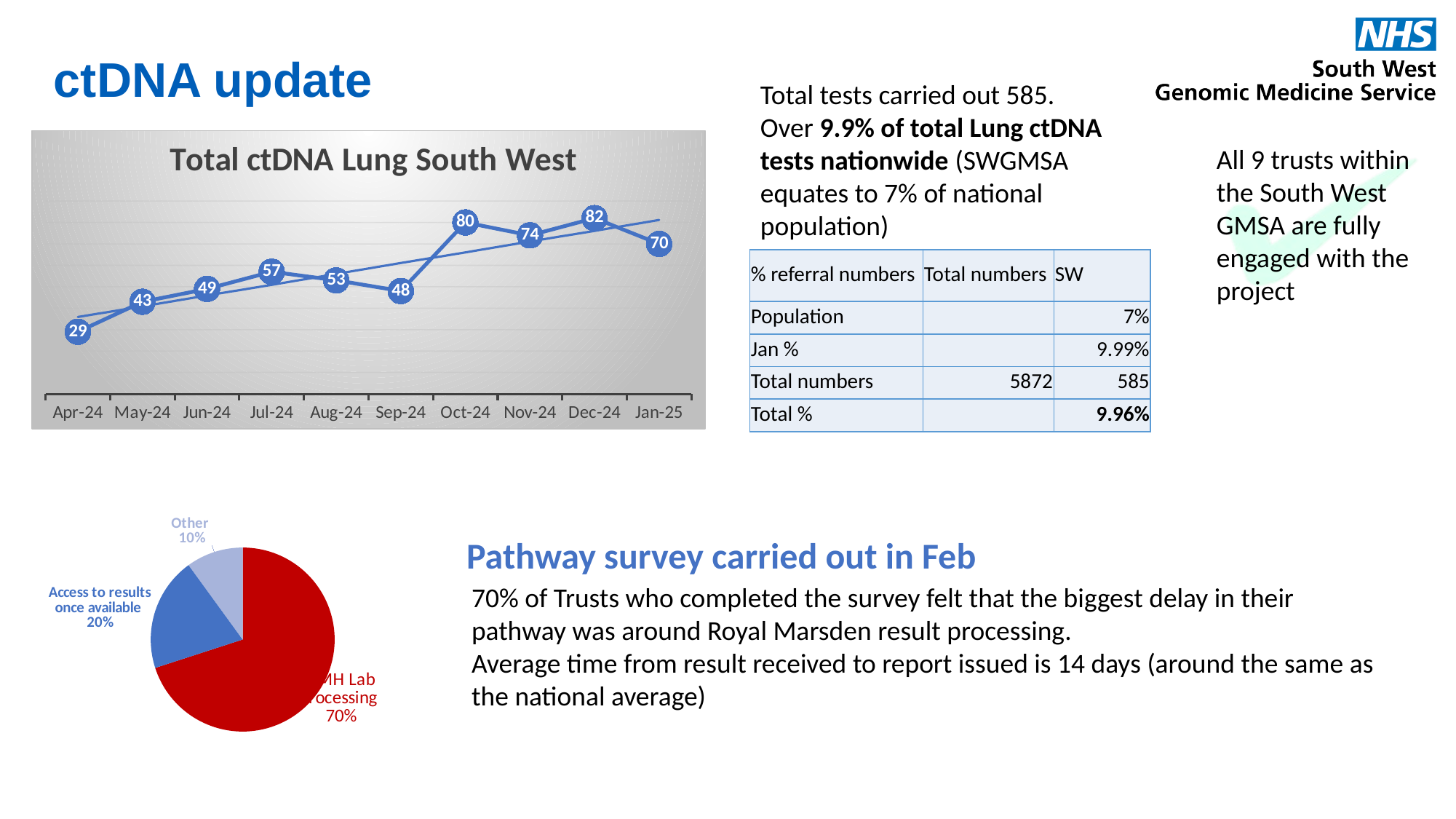
In the 'Total ctDNA Lung South West' chart, which month has the lowest value? Apr-24 In the 'Total ctDNA Lung South West' chart, which is larger, the value for Aug-24 or Sep-24? Aug-24 In the pie chart at the bottom left, what share does the 'Access to results once available' slice have? 20% In the 'Total ctDNA Lung South West' chart, what is the value for Jan-25? 70 In the 'Total ctDNA Lung South West' chart, do the values generally rise or fall from Apr-24 to Dec-24? Rise How many months are plotted in the 'Total ctDNA Lung South West' chart? 10 In the 'Total ctDNA Lung South West' chart, what is the difference between the Dec-24 and Jan-25 values? 12 In the 'Total ctDNA Lung South West' chart, what is the value for Oct-24? 80 In the 'Total ctDNA Lung South West' chart, what is the value for Apr-24? 29 In the pie chart at the bottom left, what share does the 'Other' slice have? 10% What kind of chart is 'Total ctDNA Lung South West'? Line chart In the 'Total ctDNA Lung South West' chart, which month has the highest value? Dec-24